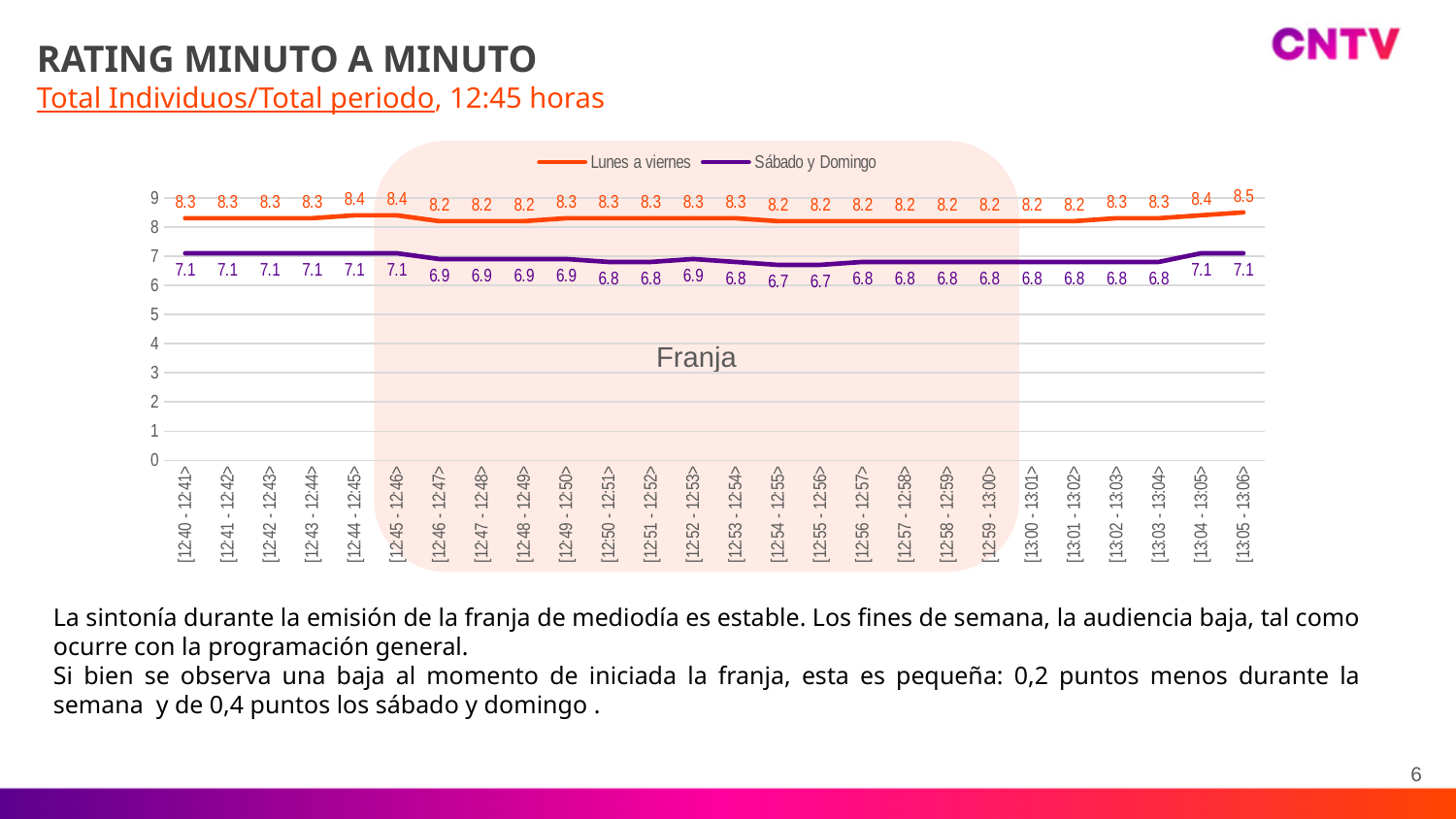
Which series has the higher value at [12:50 - 12:51>, Lunes a viernes or Sábado y Domingo? Lunes a viernes What is the value for Sábado y Domingo at [12:54 - 12:55>? 6.7 Is the value for Sábado y Domingo at [12:55 - 12:56> greater or less than 7? less What is the value for Lunes a viernes at [13:05 - 13:06>? 8.5 What label is written inside the shaded area of the chart? Franja At which time interval does Lunes a viernes reach its highest value? [13:05 - 13:06> What type of chart is shown on the slide? line chart How many series does the legend list? 2 What are the two series named in the legend? Lunes a viernes; Sábado y Domingo What is the difference between Lunes a viernes and Sábado y Domingo at [12:40 - 12:41>? 1.2 What is the value for Lunes a viernes at [12:46 - 12:47>? 8.2 What is the lowest value shown for Sábado y Domingo? 6.7